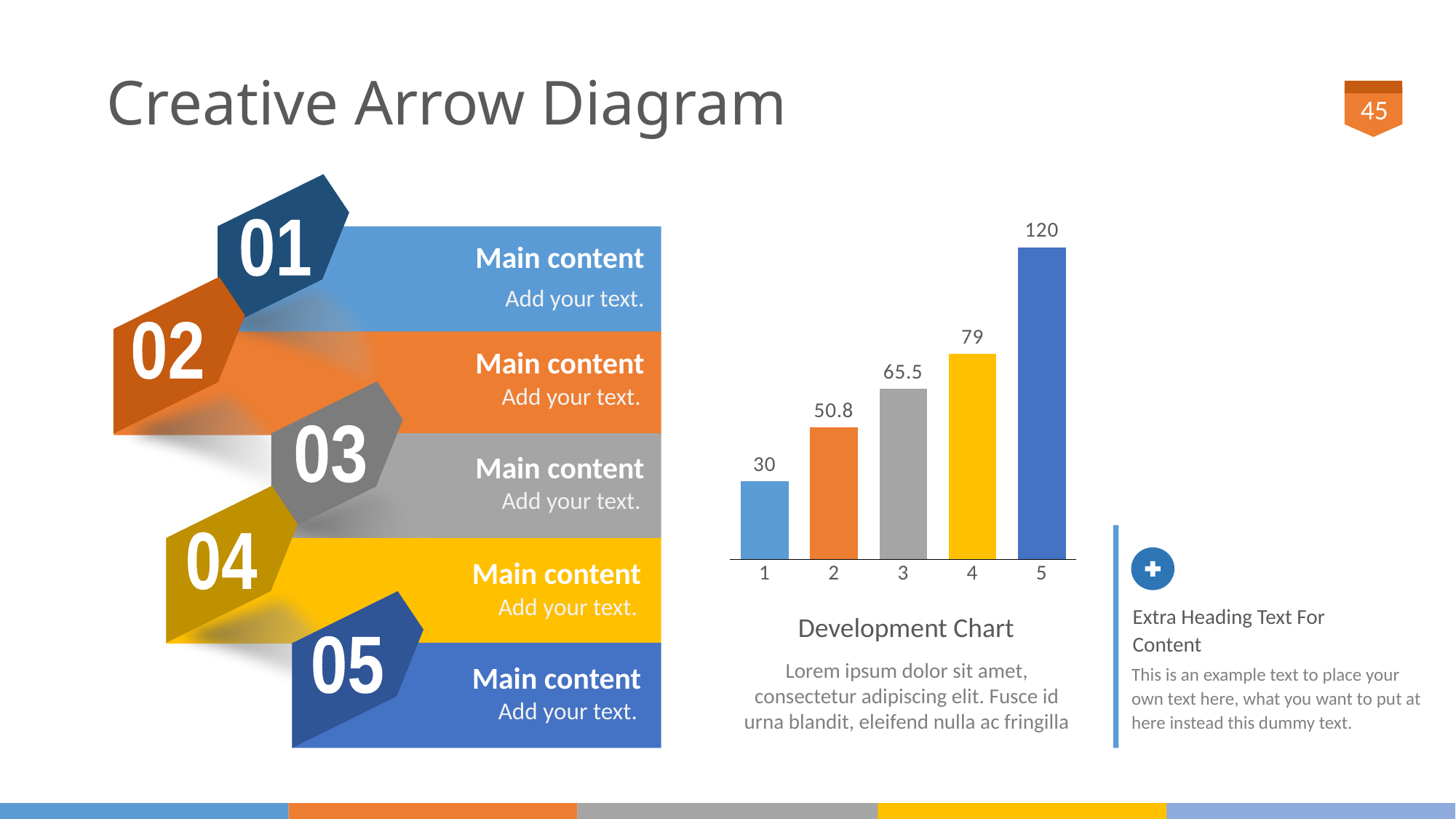
What is the value for category 1 in the Development Chart? 30 What colour is the bar for category 4 in the Development Chart? yellow Which category has the highest value in the Development Chart? 5 Which is larger in the Development Chart, the value for category 3 or category 4? 4 What type of chart is the Development Chart? bar chart What is the value for category 5 in the Development Chart? 120 What is the difference between the values for category 5 and category 4 in the Development Chart? 41 Which category has the lowest value in the Development Chart? 1 How many bars are plotted in the Development Chart? 5 What is the value for category 3 in the Development Chart? 65.5 What is the difference between the values for category 2 and category 1 in the Development Chart? 20.8 Do the values in the Development Chart rise or fall from category 1 to category 5? rise